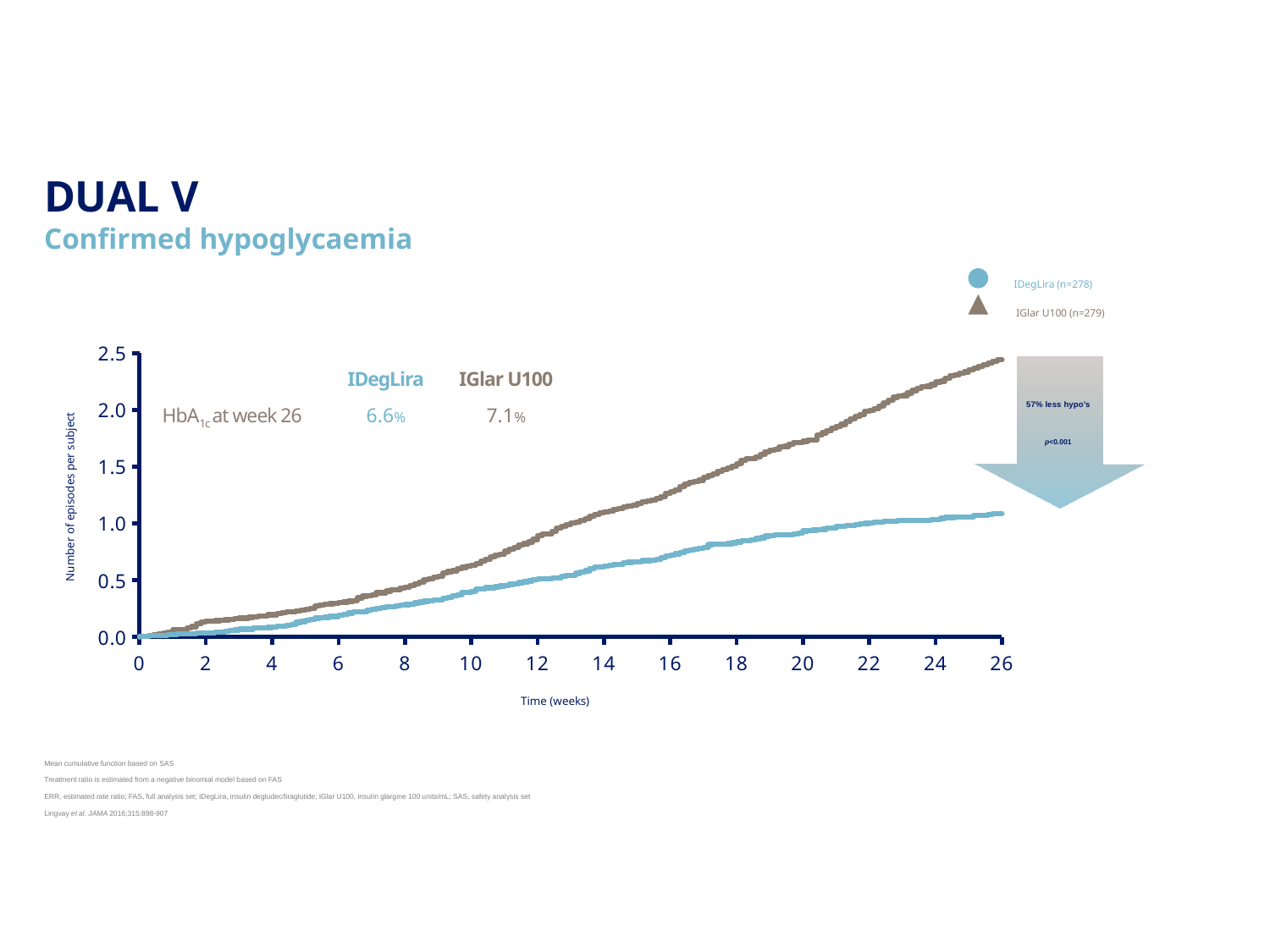
Is the value for IGlar U100 at week 26 greater or less than 2.0? greater Is the value for IGlar U100 at week 14 greater or less than 1.0? greater What is the label on the y axis of the chart? Number of episodes per subject Which series has the higher number of episodes per subject at week 26? IGlar U100 What is the label on the x axis of the chart? Time (weeks) Is the value for IDegLira at week 26 greater or less than 1.5? less What HbA1c at week 26 is shown for IDegLira? 6.6% How many series does the legend list? 2 Do the values for IGlar U100 rise or fall as time in weeks increases? rise What HbA1c at week 26 is shown for IGlar U100? 7.1% What kind of chart is shown on the slide? Line chart